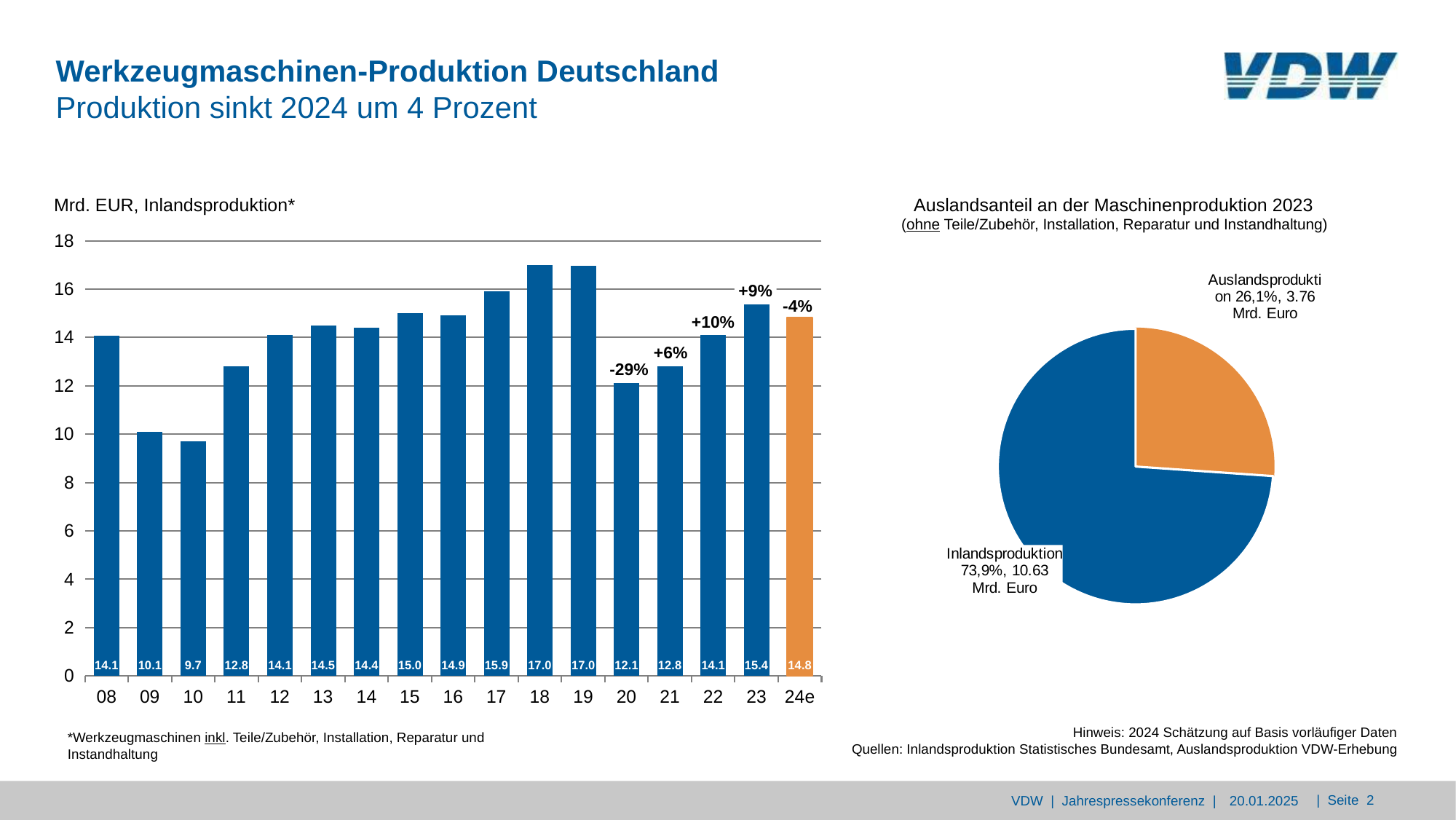
In the pie chart 'Auslandsanteil an der Maschinenproduktion 2023', what share does Auslandsproduktion have? 26,1% What kind of chart is the chart on the left of the slide? Bar chart In the pie chart 'Auslandsanteil an der Maschinenproduktion 2023', what is the value in Mrd. Euro for Inlandsproduktion? 10.63 Mrd. Euro In the bar chart 'Mrd. EUR, Inlandsproduktion*', what is the value for 2020 (20)? 12.1 In the bar chart 'Mrd. EUR, Inlandsproduktion*', what is the difference between the values for 19 and 20? 4.9 What kind of chart is the chart titled 'Auslandsanteil an der Maschinenproduktion 2023'? Pie chart In the bar chart 'Mrd. EUR, Inlandsproduktion*', how many years (bars) are shown? 17 In the bar chart 'Mrd. EUR, Inlandsproduktion*', what is the value for 24e? 14.8 In the bar chart 'Mrd. EUR, Inlandsproduktion*', which is larger, the value for 13 or the value for 14? 13 In the bar chart 'Mrd. EUR, Inlandsproduktion*', what is the value for 2023 (23)? 15.4 In the bar chart 'Mrd. EUR, Inlandsproduktion*', which year has the lowest value? 10 In the bar chart 'Mrd. EUR, Inlandsproduktion*', what percentage change is labelled above the bar for 20? -29%